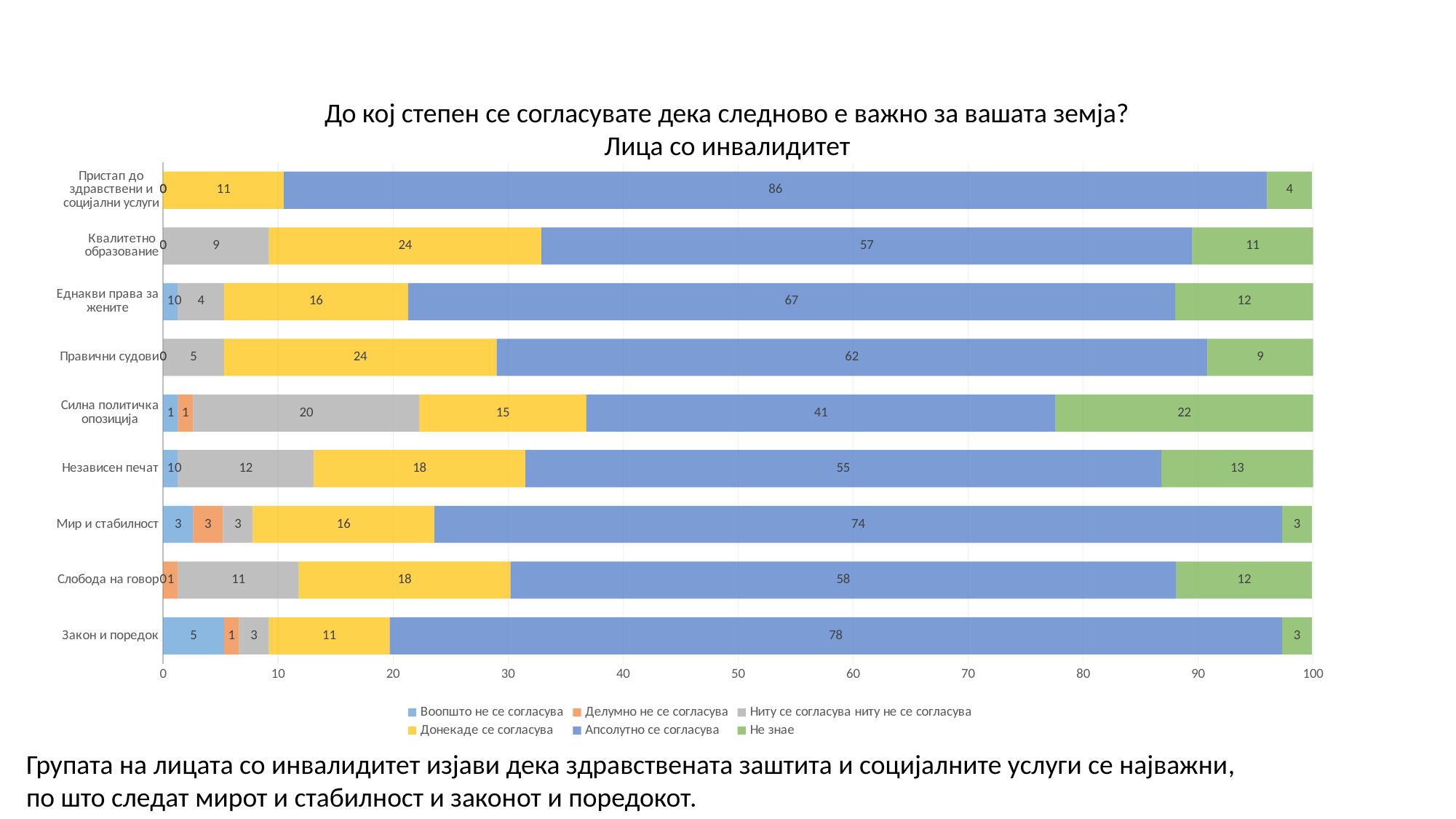
What is the value of "Не знае" for "Силна политичка опозиција"? 22 How many series does the legend list? 6 What is the value of "Ниту се согласува ниту не се согласува" for "Силна политичка опозиција"? 20 What is the value of "Донекаде се согласува" for "Квалитетно образование"? 24 How many categories are plotted on the chart? 9 What is the value of "Апсолутно се согласува" for "Пристап до здравствени и социјални услуги"? 86 What kind of chart is shown on the slide? Stacked bar chart Which is larger: the "Не знае" value for "Независен печат" or for "Правични судови"? Независен печат Which category has the lowest value for "Апсолутно се согласува"? Силна политичка опозиција What is the difference between the "Апсолутно се согласува" values for "Закон и поредок" and "Мир и стабилност"? 4 What is the second line of the chart title? Лица со инвалидитет Which category has the highest value for "Апсолутно се согласува"? Пристап до здравствени и социјални услуги